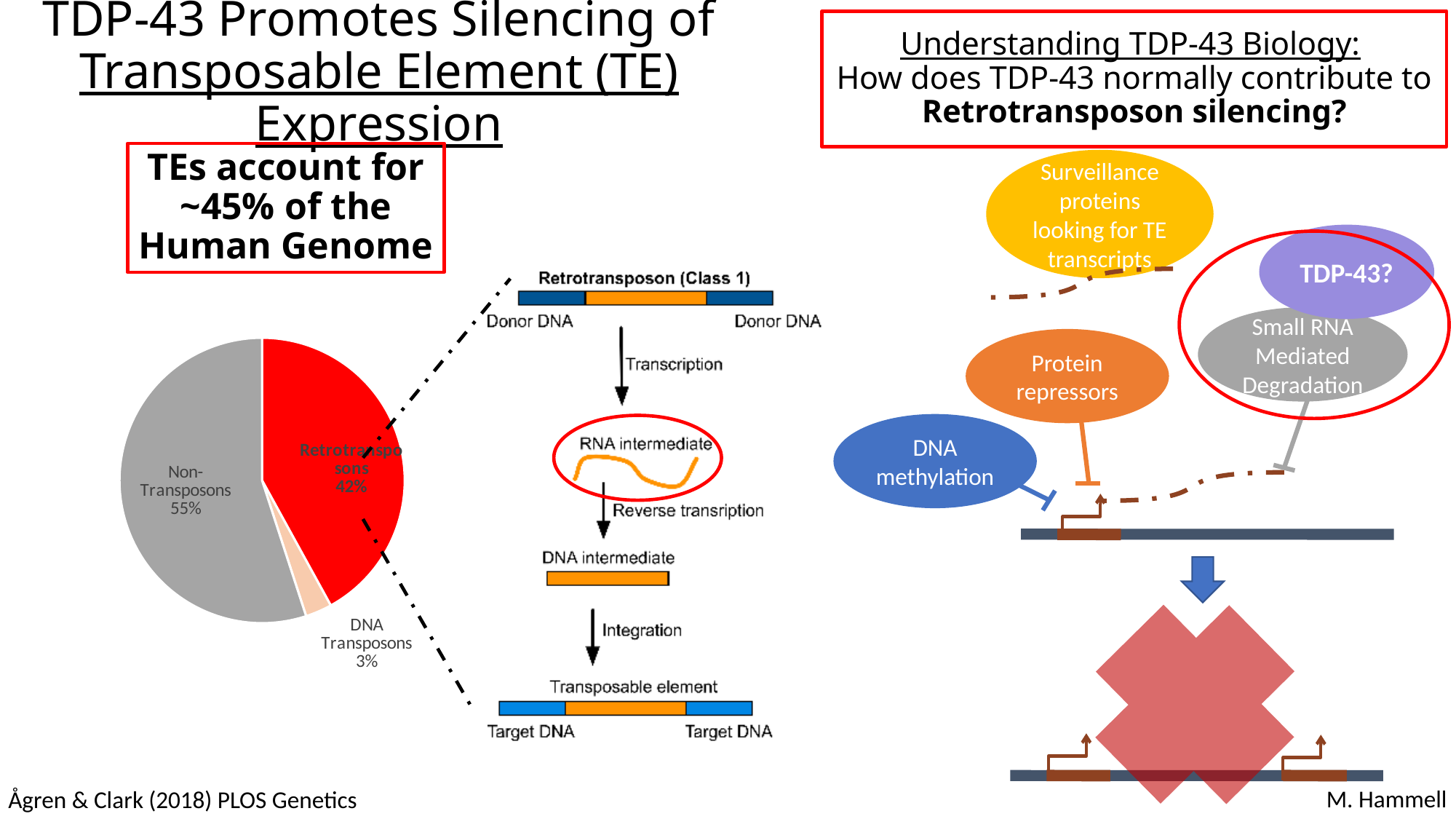
In the pie chart, what is the difference between the Retrotransposons and DNA Transposons shares? 39% What share of the pie chart is DNA Transposons? 3% In the pie chart, what is the combined share of Retrotransposons and DNA Transposons? 45% In the pie chart, which is larger: Retrotransposons or DNA Transposons? Retrotransposons How many slices does the pie chart have? 3 What colour is the Retrotransposons slice in the pie chart? red What kind of chart is shown on the left of the slide? pie chart In the pie chart, what is the difference between the Non-Transposons and Retrotransposons shares? 13% Which slice of the pie chart is the largest? Non-Transposons What share of the pie chart is Non-Transposons? 55% What share of the pie chart is Retrotransposons? 42% Which slice of the pie chart is the smallest? DNA Transposons